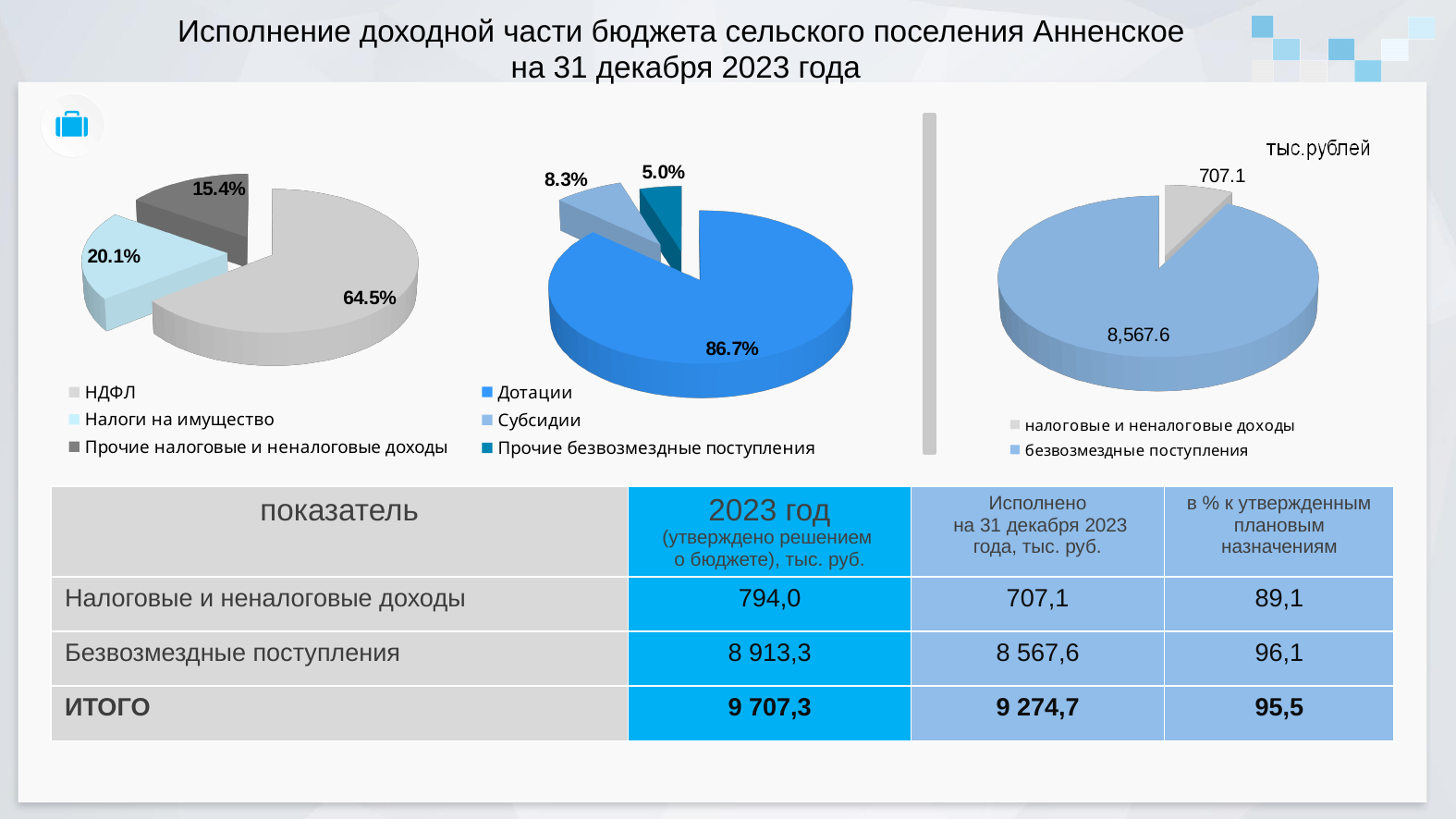
In the middle pie chart, what share does Дотации have? 86.7% In the left pie chart, what share does НДФЛ have? 64.5% What type of chart is the right chart on the slide? Pie chart In the right pie chart, what is the value for безвозмездные поступления? 8,567.6 In the middle pie chart, what share does Прочие безвозмездные поступления have? 5.0% In the middle pie chart, which is larger: Субсидии or Прочие безвозмездные поступления? Субсидии In the right pie chart, which category has the largest value? безвозмездные поступления In the left pie chart, what share does Налоги на имущество have? 20.1% In the right pie chart, what is the value for налоговые и неналоговые доходы? 707.1 In the left pie chart, what is the difference between the shares of Налоги на имущество and Прочие налоговые и неналоговые доходы? 4.7% How many slices does the middle pie chart have? 3 In the left pie chart, which category has the smallest share? Прочие налоговые и неналоговые доходы